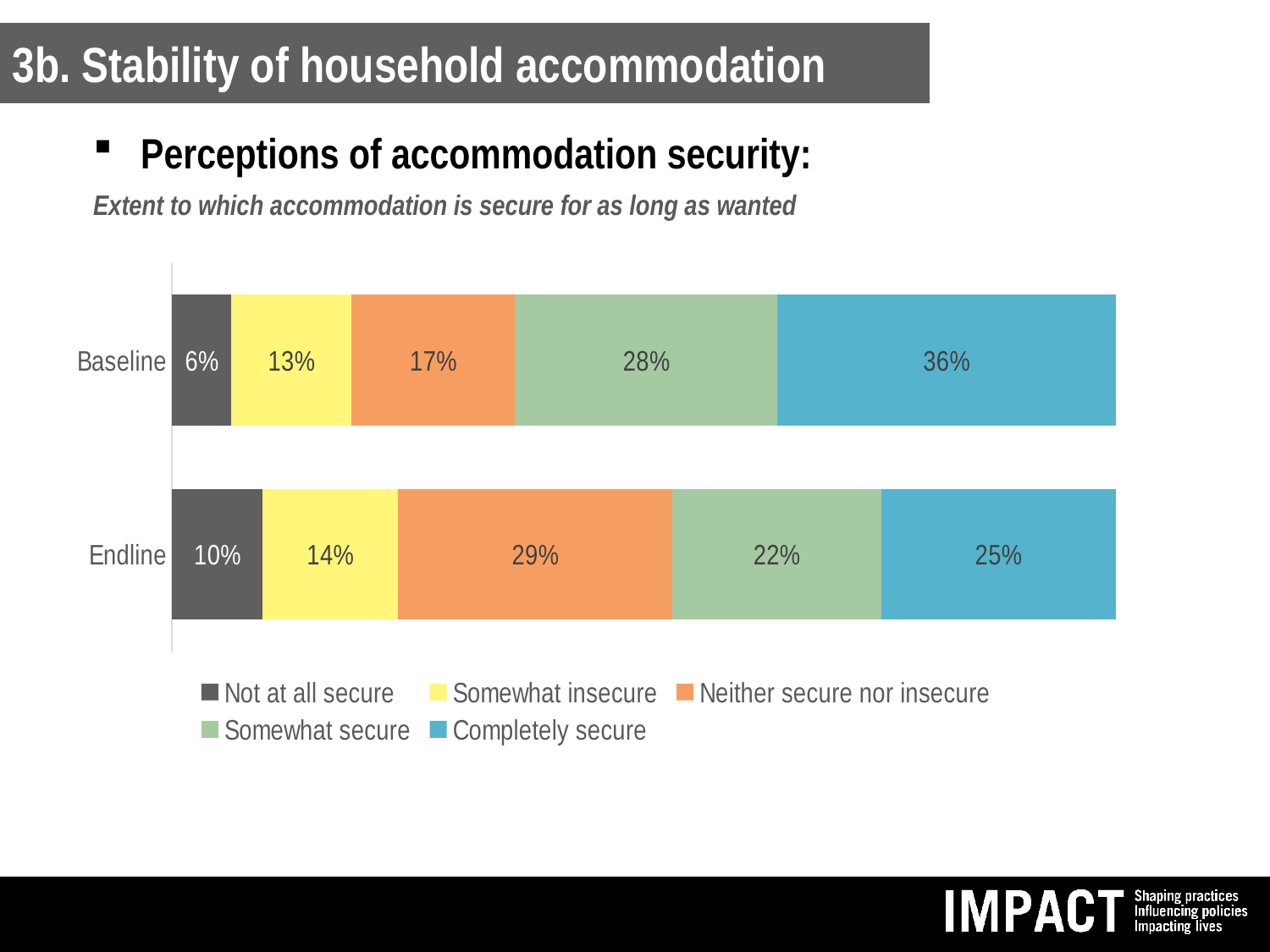
Is the 'Neither secure nor insecure' share larger at Baseline or at Endline? Endline Which response category has the smallest share at Endline? Not at all secure What type of chart is shown on the slide? Stacked bar chart How many bars are shown in the chart? 2 Which response category has the largest share at Baseline? Completely secure By how many percentage points did 'Completely secure' change from Baseline to Endline? 11 percentage points (decreased from 36% to 25%) What percentage of households reported 'Somewhat secure' at Endline? 22% What percentage of households reported 'Completely secure' at Baseline? 36% What percentage of households reported 'Not at all secure' at Baseline? 6% What percentage of households reported 'Neither secure nor insecure' at Endline? 29% How many series does the legend list? 5 What colour represents 'Somewhat insecure' in the chart? Yellow